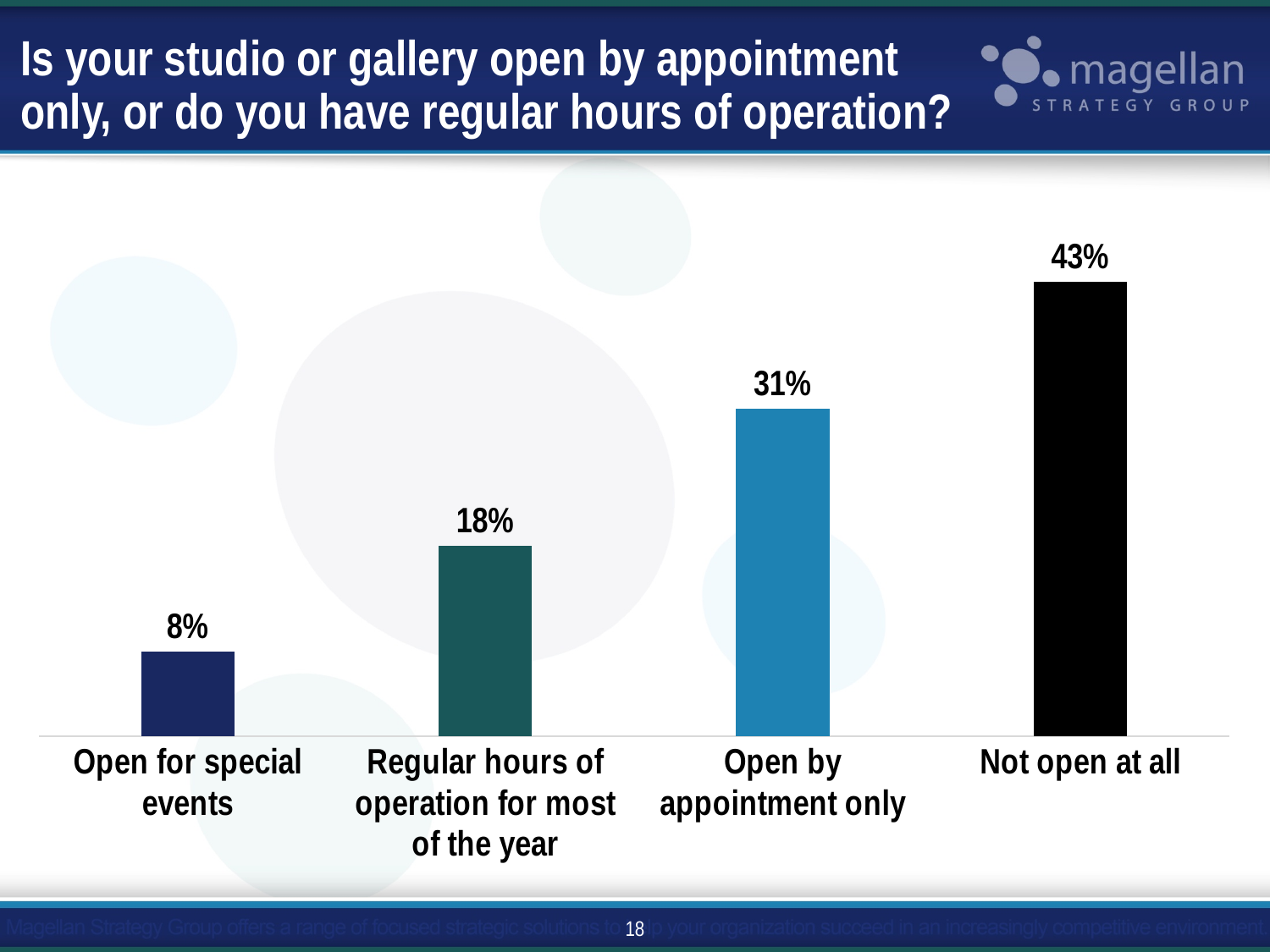
Which category has the highest value? Not open at all Do the values rise or fall from left to right across the categories? Rise What is the difference between 'Not open at all' and 'Open by appointment only'? 12% What is the value for 'Open for special events'? 8% What percentage of respondents said their studio or gallery is not open at all? 43% What percentage have regular hours of operation for most of the year? 18% What is the difference between 'Regular hours of operation for most of the year' and 'Open for special events'? 10% How many categories are shown in the chart? 4 What is the value for 'Open by appointment only'? 31% Which category has the lowest value? Open for special events What kind of chart is shown on the slide? Bar chart Which is larger: 'Open by appointment only' or 'Regular hours of operation for most of the year'? Open by appointment only